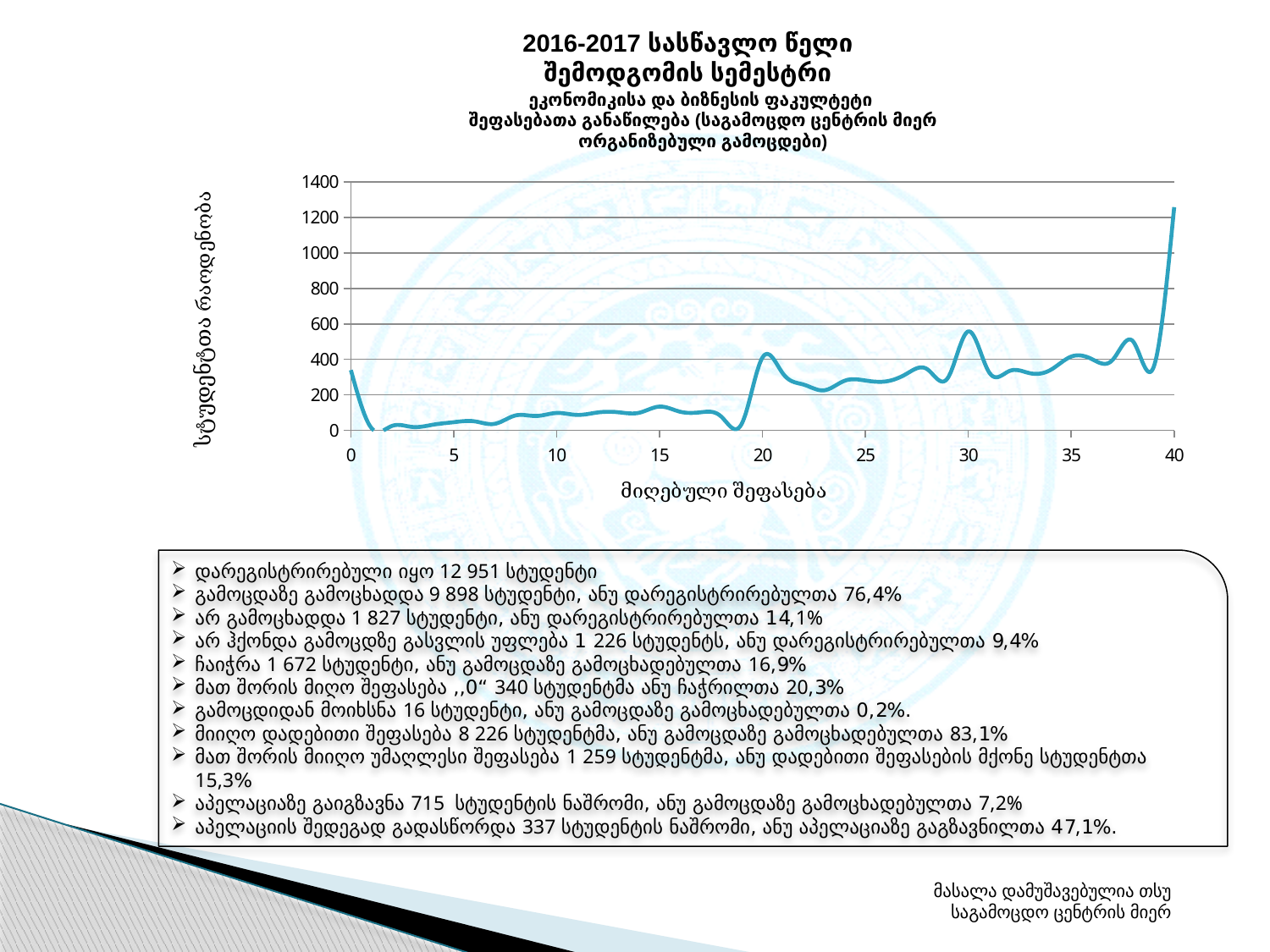
Is the value of the line at x = 25 greater or less than 200? greater Is the value of the line at x = 40 greater or less than 1000? greater What is the label of the x axis? მიღებული შეფასება Is the value of the line at x = 30 greater or less than 400? greater Which is larger: the value of the line at x = 0 or at x = 5? x = 0 At which value on the x axis (მიღებული შეფასება) does the line reach its highest point? 40 What kind of chart is shown on the slide? line chart What is the highest tick value shown on the y axis? 1400 How many labelled tick marks are there on the x axis? 9 Which is larger: the value of the line at x = 30 or at x = 10? x = 30